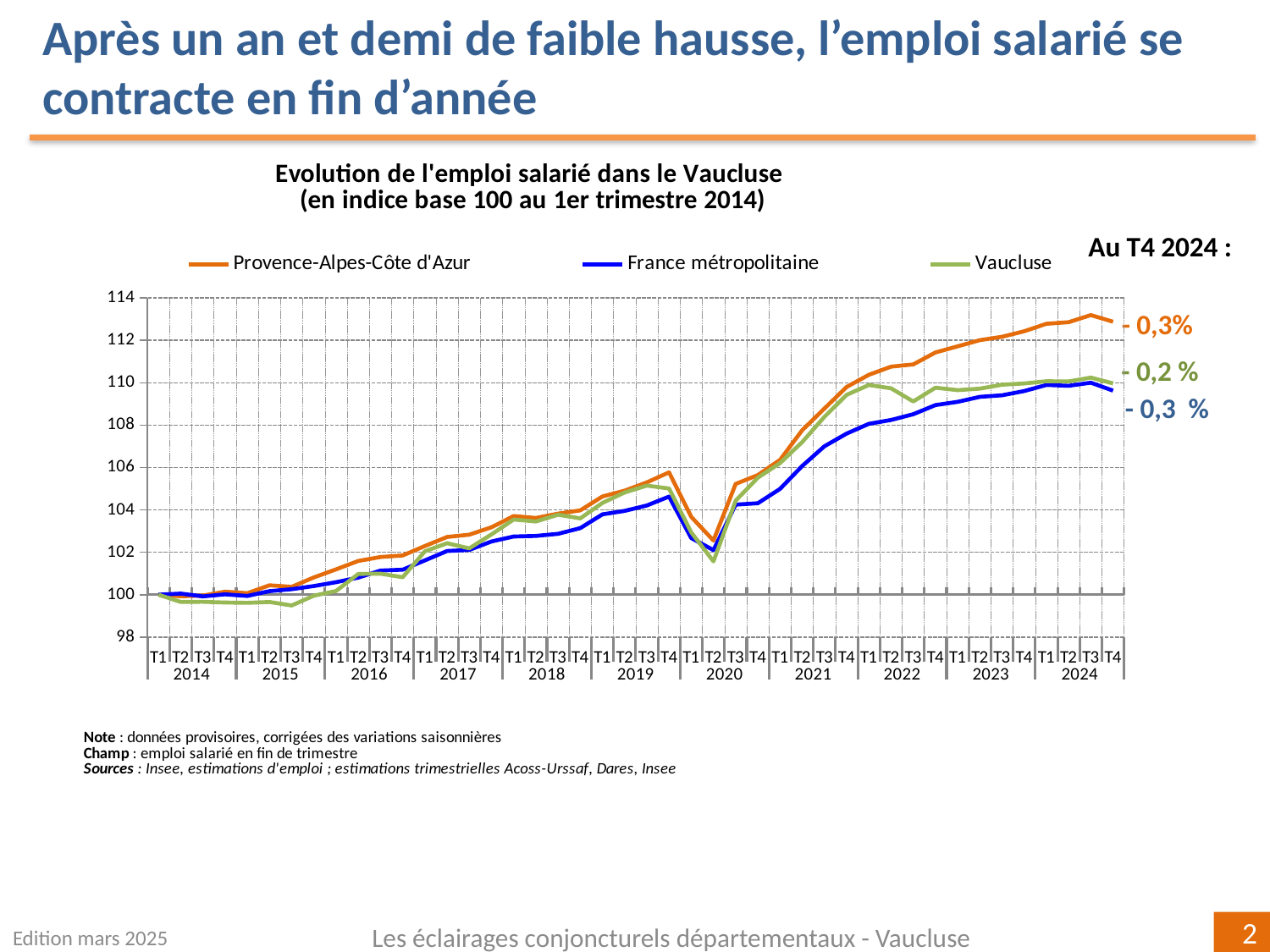
Which series are listed in the legend? Provence-Alpes-Côte d'Azur, France métropolitaine, Vaucluse Is the value for Provence-Alpes-Côte d'Azur at T4 2024 greater or less than 112? greater What is the index value of all three series at T1 2014? 100 What change is annotated for Provence-Alpes-Côte d'Azur at T4 2024? - 0,3% How many series does the legend list? 3 What change is annotated for Vaucluse at T4 2024? - 0,2 % Which series has the highest value at T4 2024? Provence-Alpes-Côte d'Azur At T4 2024, which is larger: Provence-Alpes-Côte d'Azur or France métropolitaine? Provence-Alpes-Côte d'Azur What type of chart is shown on the slide? line chart Is the value for Vaucluse at T2 2020 greater or less than 102? less Overall, do the series rise or fall from 2014 to 2024? rise Is the value for France métropolitaine at T4 2024 greater or less than 108? greater